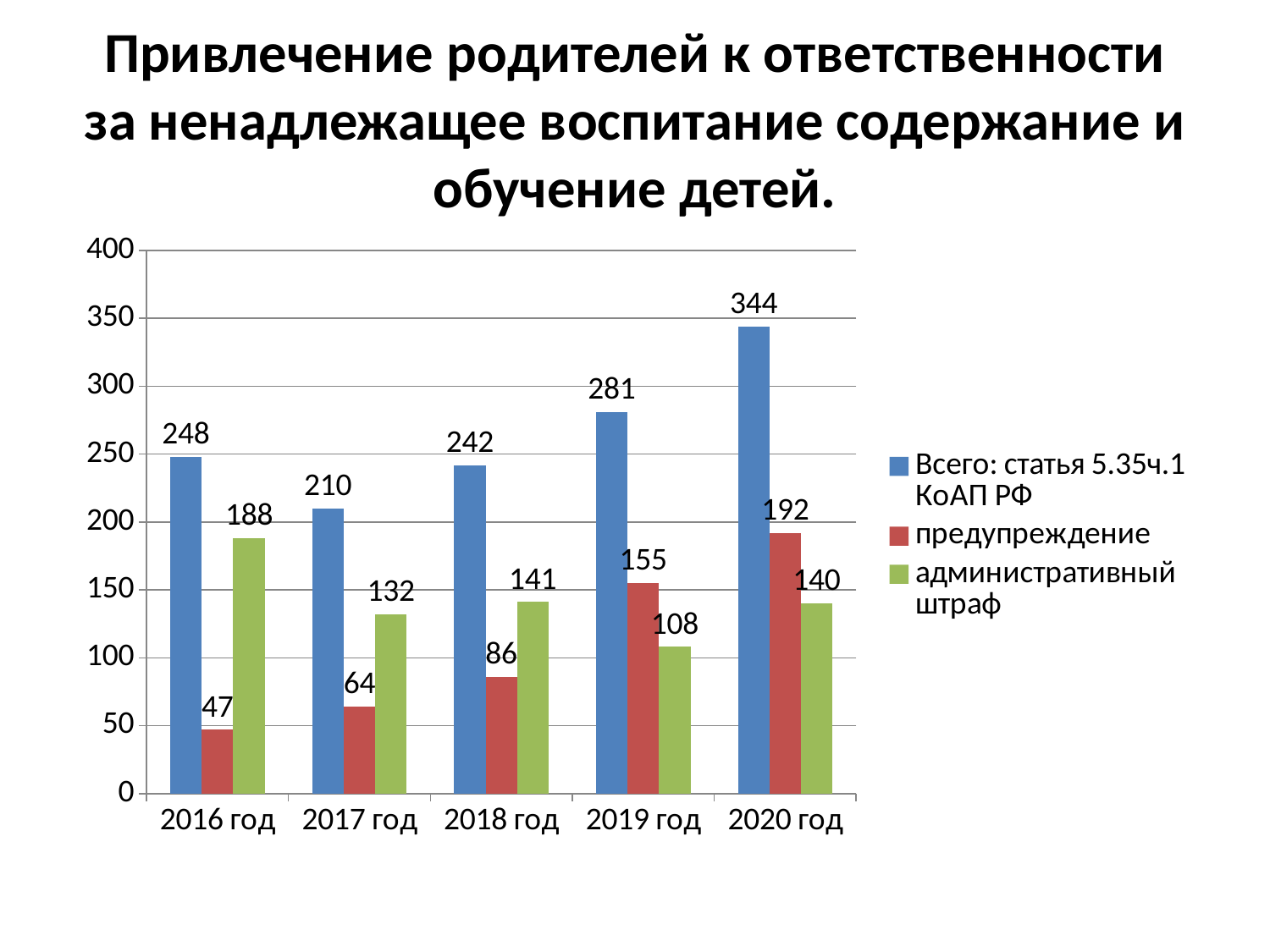
Which is larger in 2019 год: "предупреждение" or "административный штраф"? предупреждение What kind of chart is shown on the slide? bar chart In which year is the value for "предупреждение" lowest? 2016 год What is the value for "предупреждение" in 2016 год? 47 Does the value for "предупреждение" rise or fall from 2016 год to 2020 год? rise In which year is the value for "Всего: статья 5.35ч.1 КоАП РФ" highest? 2020 год What is the value for "административный штраф" in 2018 год? 141 How many series does the legend list? 3 What is the difference between the "Всего: статья 5.35ч.1 КоАП РФ" values for 2020 год and 2019 год? 63 How many years are shown on the x axis? 5 What is the value for "Всего: статья 5.35ч.1 КоАП РФ" in 2020 год? 344 Is the value for "административный штраф" in 2016 год greater or less than 150? greater